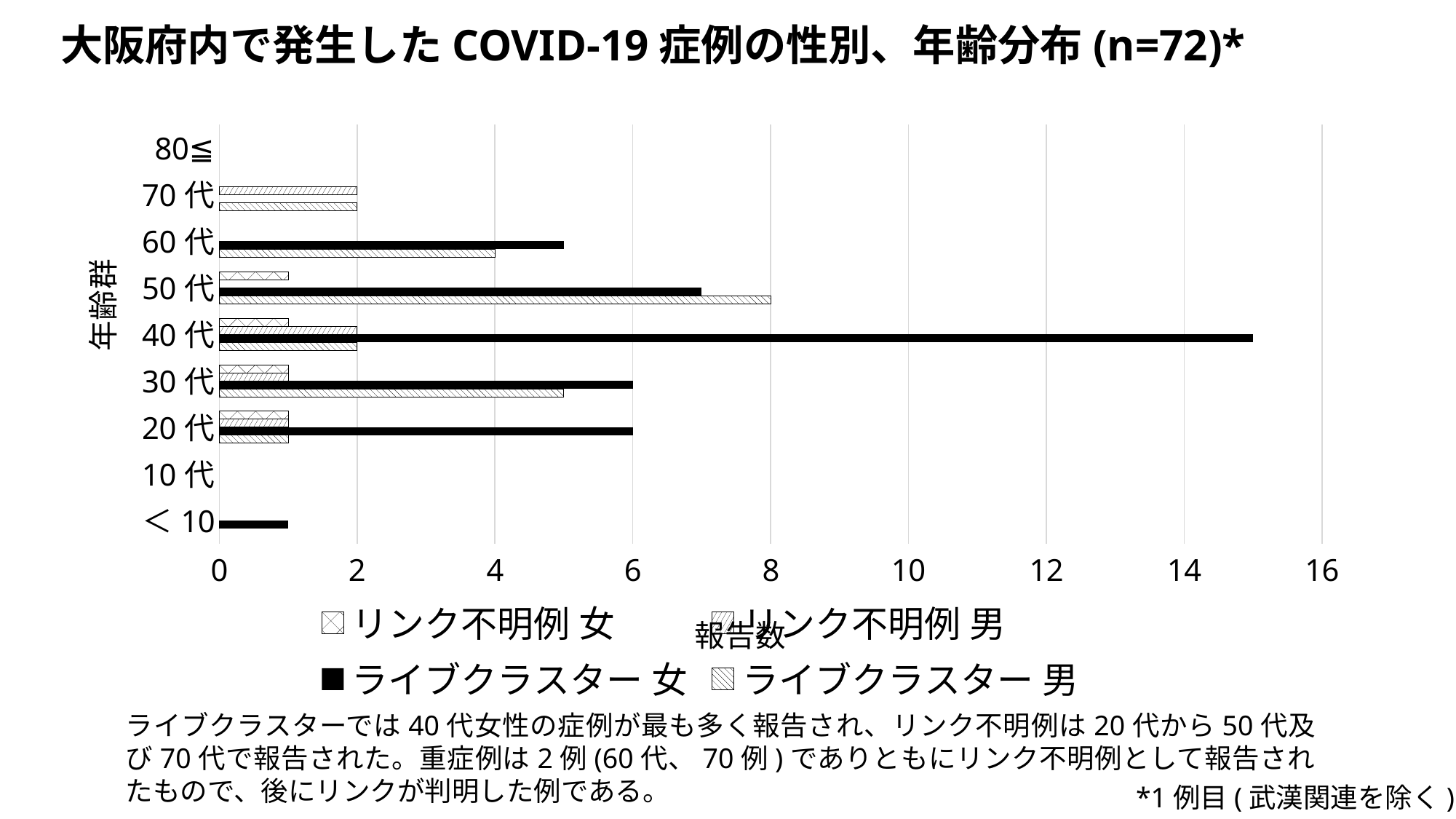
Which age group has the highest value for ライブクラスター 女? 40代 What kind of chart is shown on the slide? bar chart What is the value for ライブクラスター 男 in the 60代 age group? 4 How many age groups are shown on the y axis? 9 What is the difference between the ライブクラスター 男 values for 50代 and 60代? 4 What is the value for ライブクラスター 男 in the 50代 age group? 8 How many series does the legend list? 4 Is the value for ライブクラスター 女 in the 50代 age group greater or less than 6? greater What is the value for リンク不明例 男 in the 70代 age group? 2 What is the value for ライブクラスター 女 in the 30代 age group? 6 Is the value for ライブクラスター 女 in the 40代 age group greater or less than 14? greater Which age group has the larger value for ライブクラスター 男, 50代 or 60代? 50代